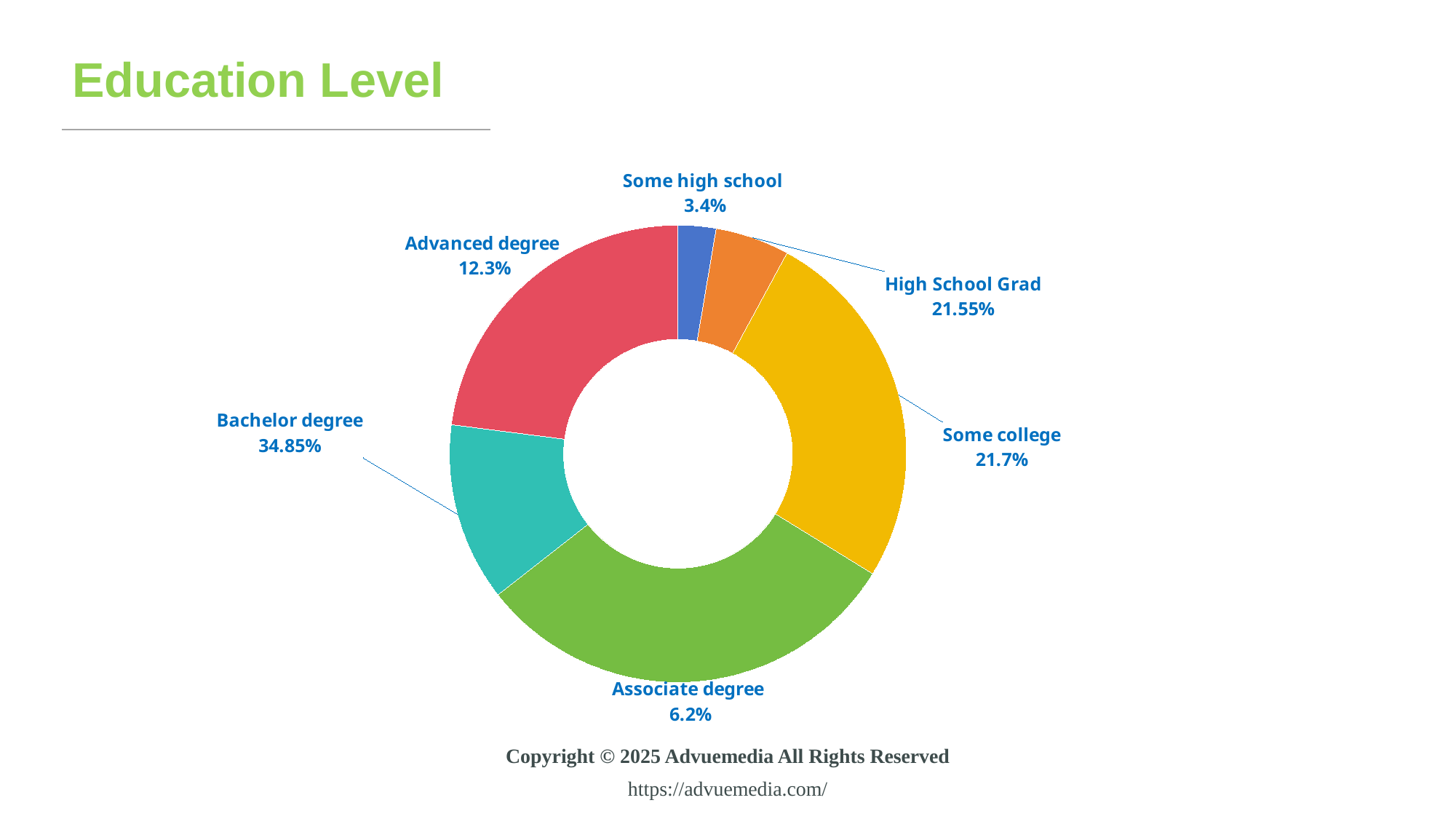
What is the difference between the labelled percentages for Some college and High School Grad? 0.15% What kind of chart is shown on the slide? Pie chart (donut) What percentage is shown for Associate degree? 6.2% How many education categories are labelled on the chart? 6 What percentage is shown for Advanced degree? 12.3% What percentage is shown for Bachelor degree? 34.85% What is the difference between the labelled percentages for Advanced degree and Some high school? 8.9% What percentage is shown for Some high school? 3.4% What is the title of the slide? Education Level What colour is the Some college slice? Yellow What percentage is shown for High School Grad? 21.55% What percentage is shown for Some college? 21.7%